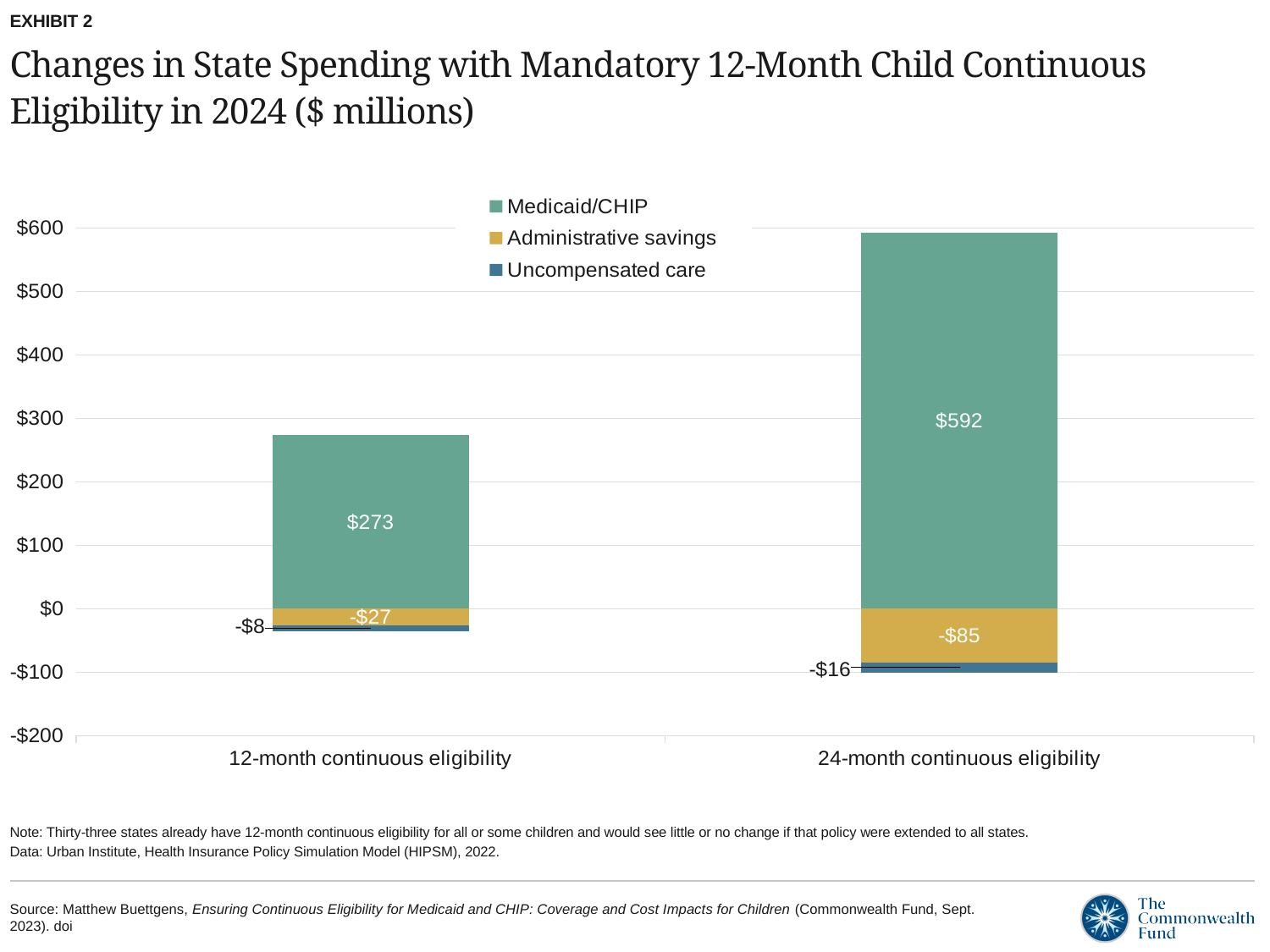
What kind of chart is shown on the slide? Stacked bar chart How many series does the legend list? 3 What is the Medicaid/CHIP value for 12-month continuous eligibility? $273 Is the Medicaid/CHIP value for 12-month continuous eligibility greater or less than $300? less What is the Uncompensated care value for 12-month continuous eligibility? -$8 How many categories are shown on the x axis? 2 What is the Administrative savings value for 24-month continuous eligibility? -$85 Which category has the higher Medicaid/CHIP value? 24-month continuous eligibility What is the Medicaid/CHIP value for 24-month continuous eligibility? $592 What is the difference between the Medicaid/CHIP values for 24-month and 12-month continuous eligibility? $319 What is the Uncompensated care value for 24-month continuous eligibility? -$16 Is the Administrative savings value for 12-month continuous eligibility larger or smaller in magnitude than for 24-month continuous eligibility? smaller